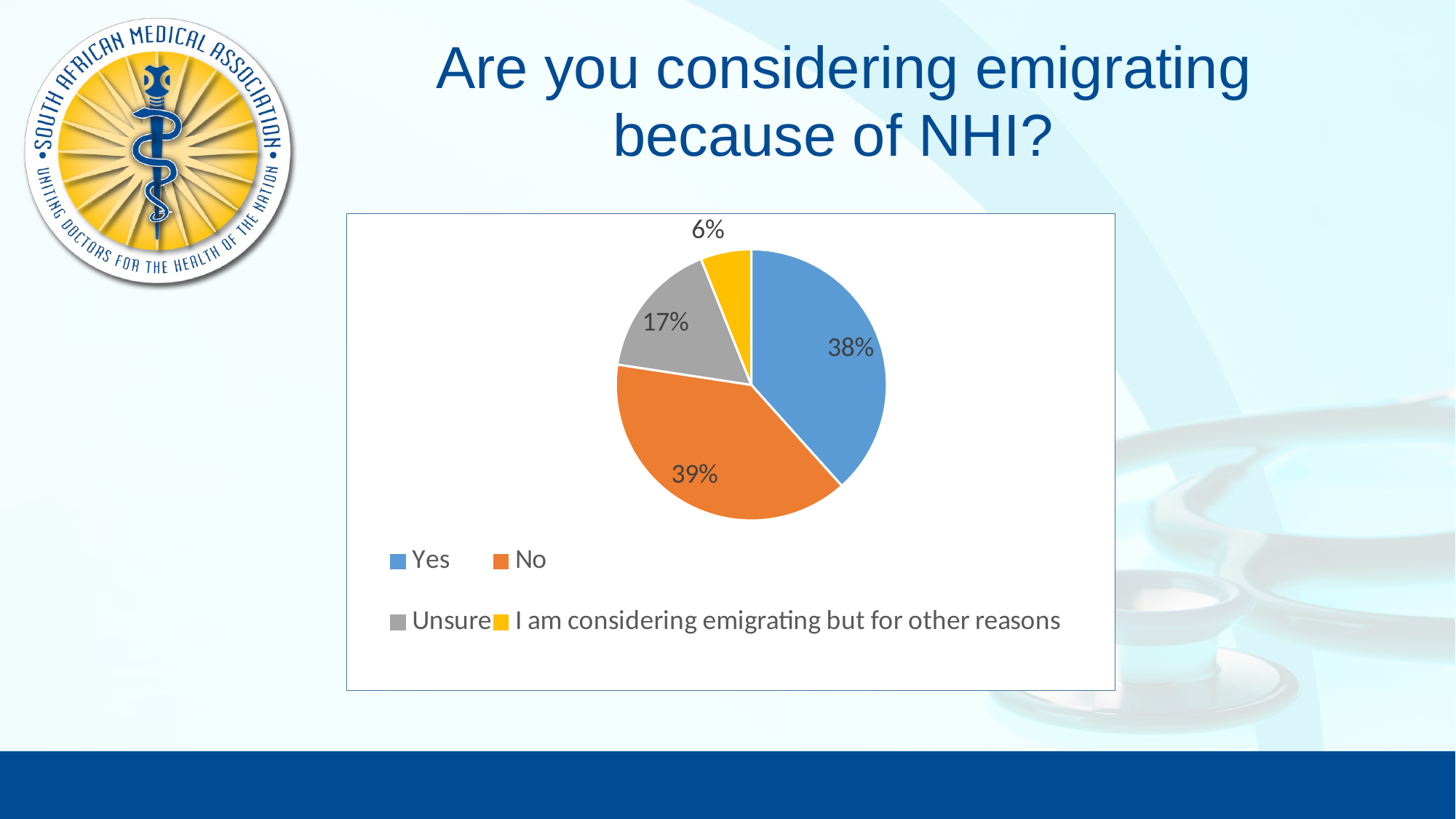
How many entries does the legend list? 4 What percentage of respondents answered "Unsure"? 17% What is the difference in percentage points between the "Unsure" slice and the "I am considering emigrating but for other reasons" slice? 11 What percentage of respondents answered "Yes"? 38% What colour is the "Unsure" slice? grey Which response has the largest share of the pie? No What kind of chart is shown on the slide? pie chart What percentage of respondents answered "No"? 39% Which response has the smallest share of the pie? I am considering emigrating but for other reasons What percentage of respondents chose "I am considering emigrating but for other reasons"? 6% How many slices does the pie chart have? 4 Which is larger, the "Yes" slice or the "Unsure" slice? Yes